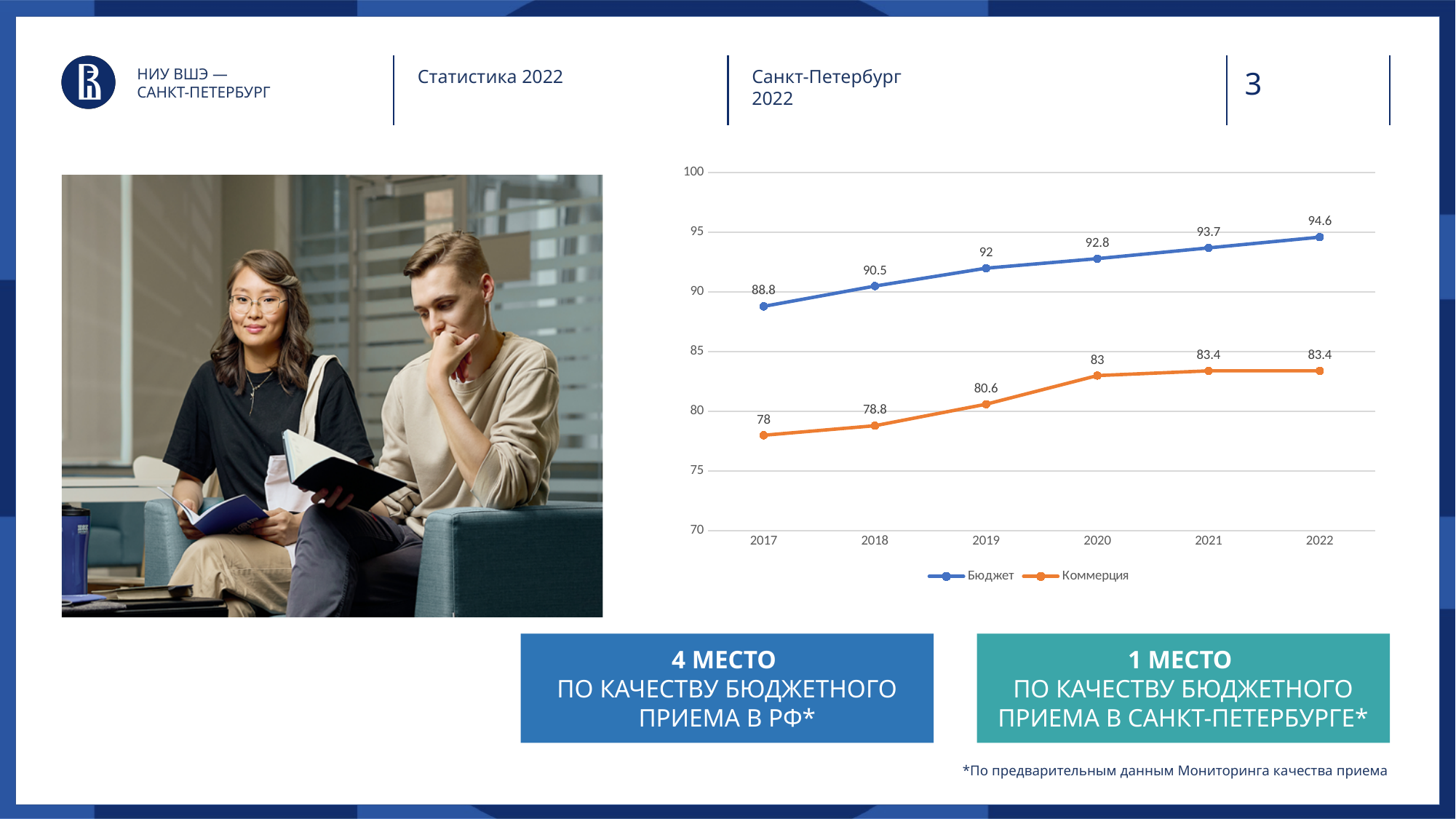
What kind of chart is shown on the slide? line chart How many series does the legend list? 2 In which year is the Бюджет series highest? 2022 What is the difference between the Бюджет and Коммерция values in 2020? 9.8 What is the value for Бюджет in 2018? 90.5 Does the Бюджет series rise or fall from 2017 to 2022? rise How many years are shown on the x axis? 6 What is the value for Коммерция in 2019? 80.6 What is the value for Бюджет in 2022? 94.6 Which series has the larger value in 2021, Бюджет or Коммерция? Бюджет In which year is the Коммерция series lowest? 2017 What is the value for Коммерция in 2017? 78